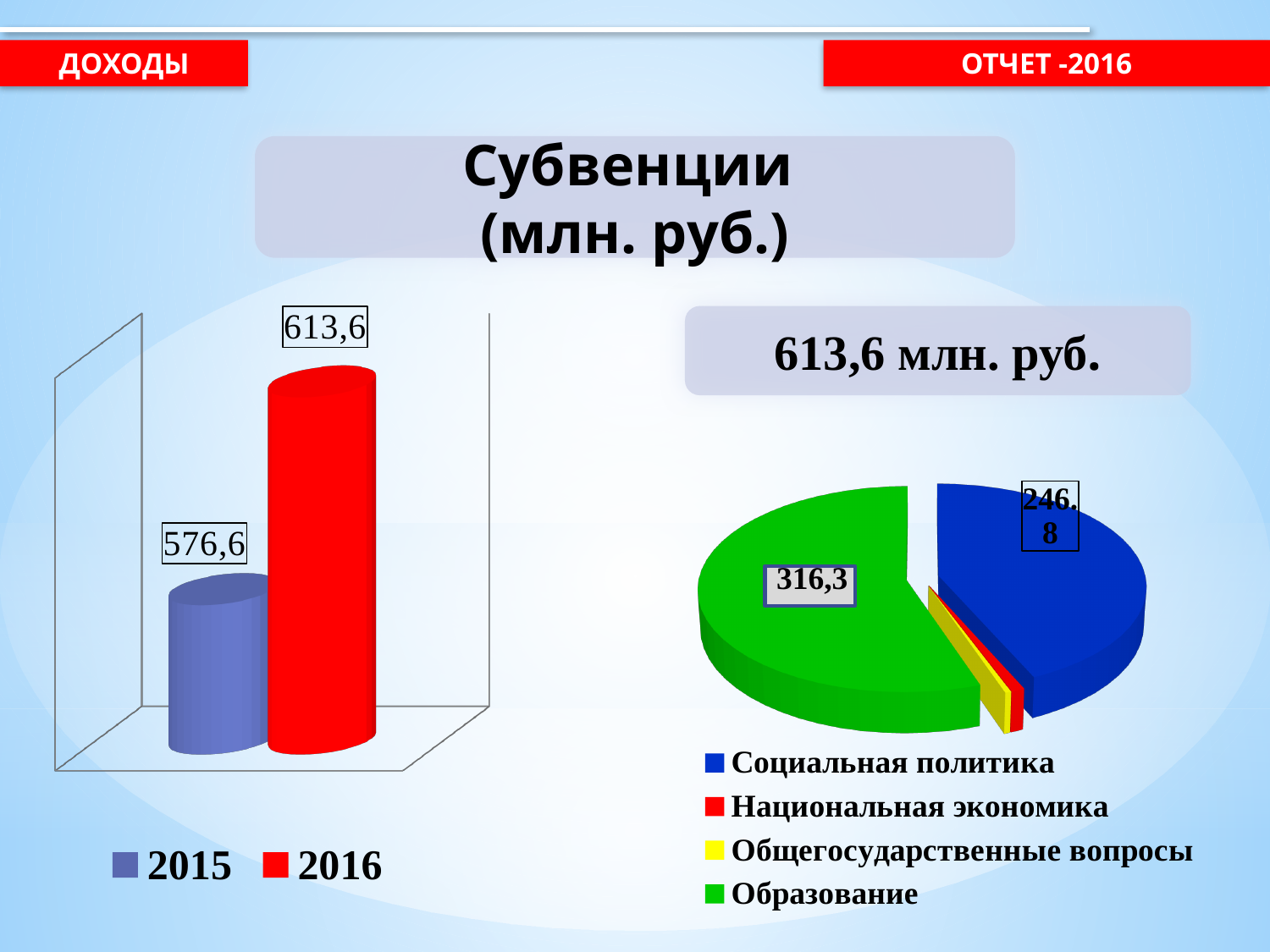
In the bar chart on the left, what is the difference between the 2016 and 2015 values? 37 What kind of chart is the chart on the left of the slide? bar chart How many series does the legend of the bar chart on the left list? 2 In the pie chart on the right, what is the value for Образование? 316,3 In the pie chart on the right, which category has the largest slice? Образование How many categories does the legend of the pie chart on the right list? 4 In the pie chart on the right, what is the value for Социальная политика? 246.8 In the bar chart on the left, do the values rise or fall from 2015 to 2016? rise In the bar chart on the left, what is the value for 2015? 576,6 In the pie chart on the right, what is the difference between the values for Образование and Социальная политика? 69,5 In the bar chart on the left, which is larger, the value for 2015 or for 2016? 2016 In the bar chart on the left, what is the value for 2016? 613,6